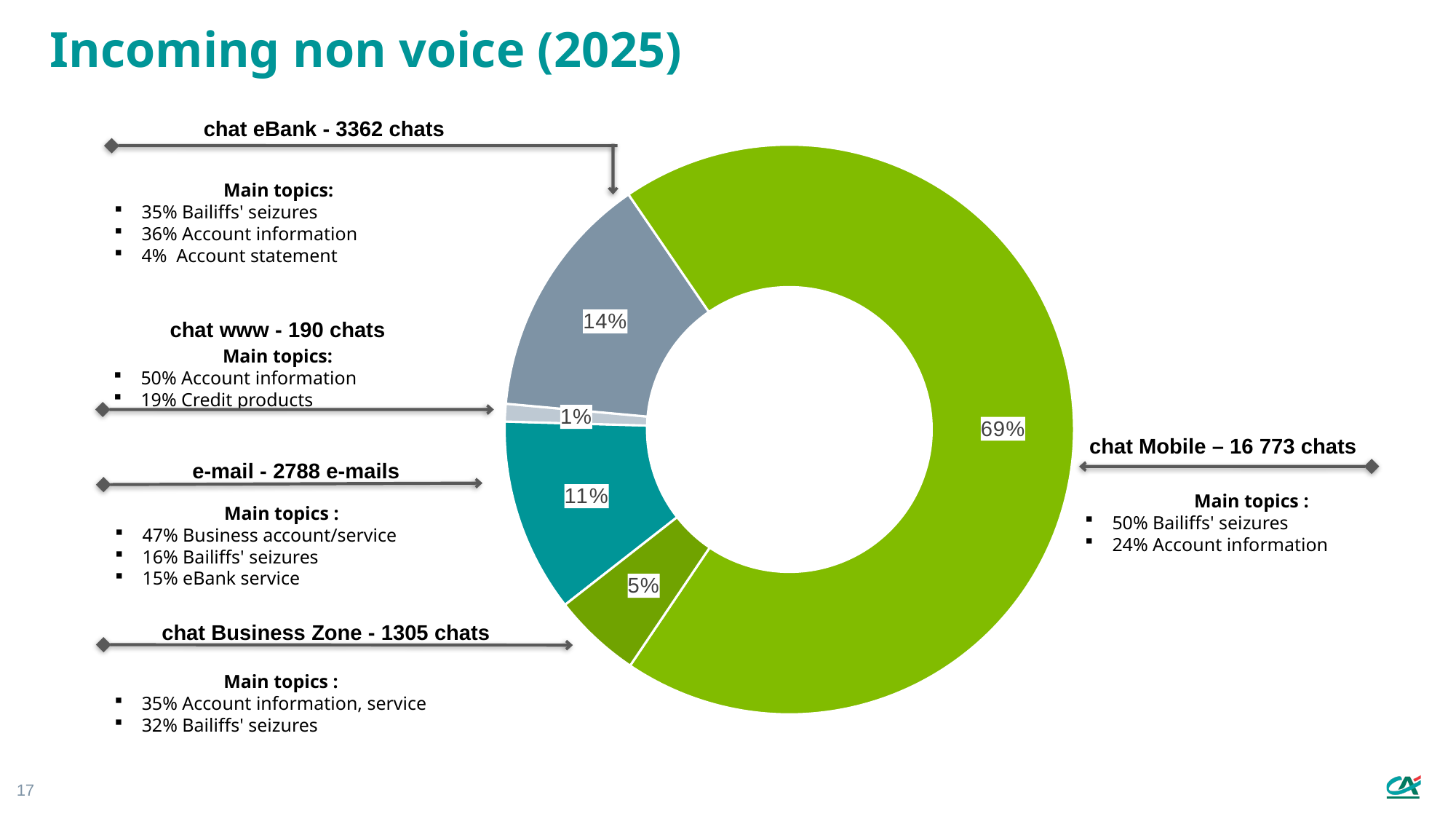
How many chats are reported for chat Mobile? 16 773 chats What share of the pie does chat Mobile account for? 69% Which channel has the smallest slice of the pie? chat www What share of the pie does chat eBank account for? 14% What share of the pie does chat Business Zone account for? 5% Which slice is larger, chat eBank or e-mail? chat eBank How many e-mails are reported for the e-mail channel? 2788 e-mails What kind of chart is shown on the slide? Pie chart (donut) How many slices does the pie chart have? 5 Which channel has the largest slice of the pie? chat Mobile